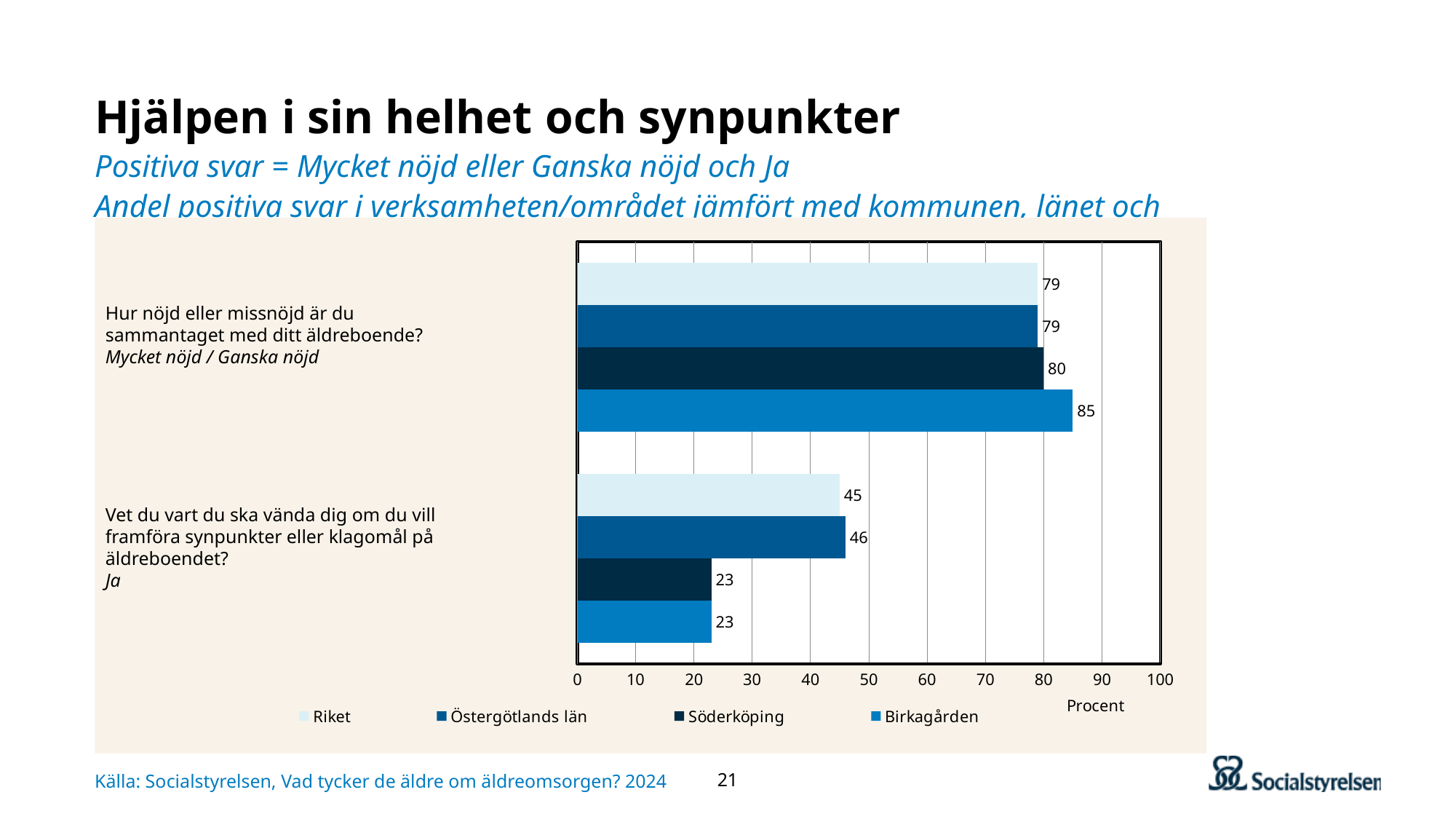
What is the value for Östergötlands län on the question "Hur nöjd eller missnöjd är du sammantaget med ditt äldreboende?"? 79 What is the difference between the Östergötlands län value and the Söderköping value on the question "Vet du vart du ska vända dig om du vill framföra synpunkter eller klagomål på äldreboendet?"? 23 What is the difference between the Birkagården value and the Riket value on the question "Hur nöjd eller missnöjd är du sammantaget med ditt äldreboende?"? 6 What kind of chart is shown on the slide? Bar chart What is the value for Riket on the question "Vet du vart du ska vända dig om du vill framföra synpunkter eller klagomål på äldreboendet?"? 45 What is the value for Birkagården on the question "Hur nöjd eller missnöjd är du sammantaget med ditt äldreboende?"? 85 What unit is shown on the horizontal axis of the chart? Procent Which is larger on the question "Vet du vart du ska vända dig om du vill framföra synpunkter eller klagomål på äldreboendet?": the value for Riket or the value for Birkagården? Riket How many series does the legend list? 4 Which series has the highest value on the question "Hur nöjd eller missnöjd är du sammantaget med ditt äldreboende?"? Birkagården What is the value for Söderköping on the question "Vet du vart du ska vända dig om du vill framföra synpunkter eller klagomål på äldreboendet?"? 23 Which series has the highest value on the question "Vet du vart du ska vända dig om du vill framföra synpunkter eller klagomål på äldreboendet?"? Östergötlands län